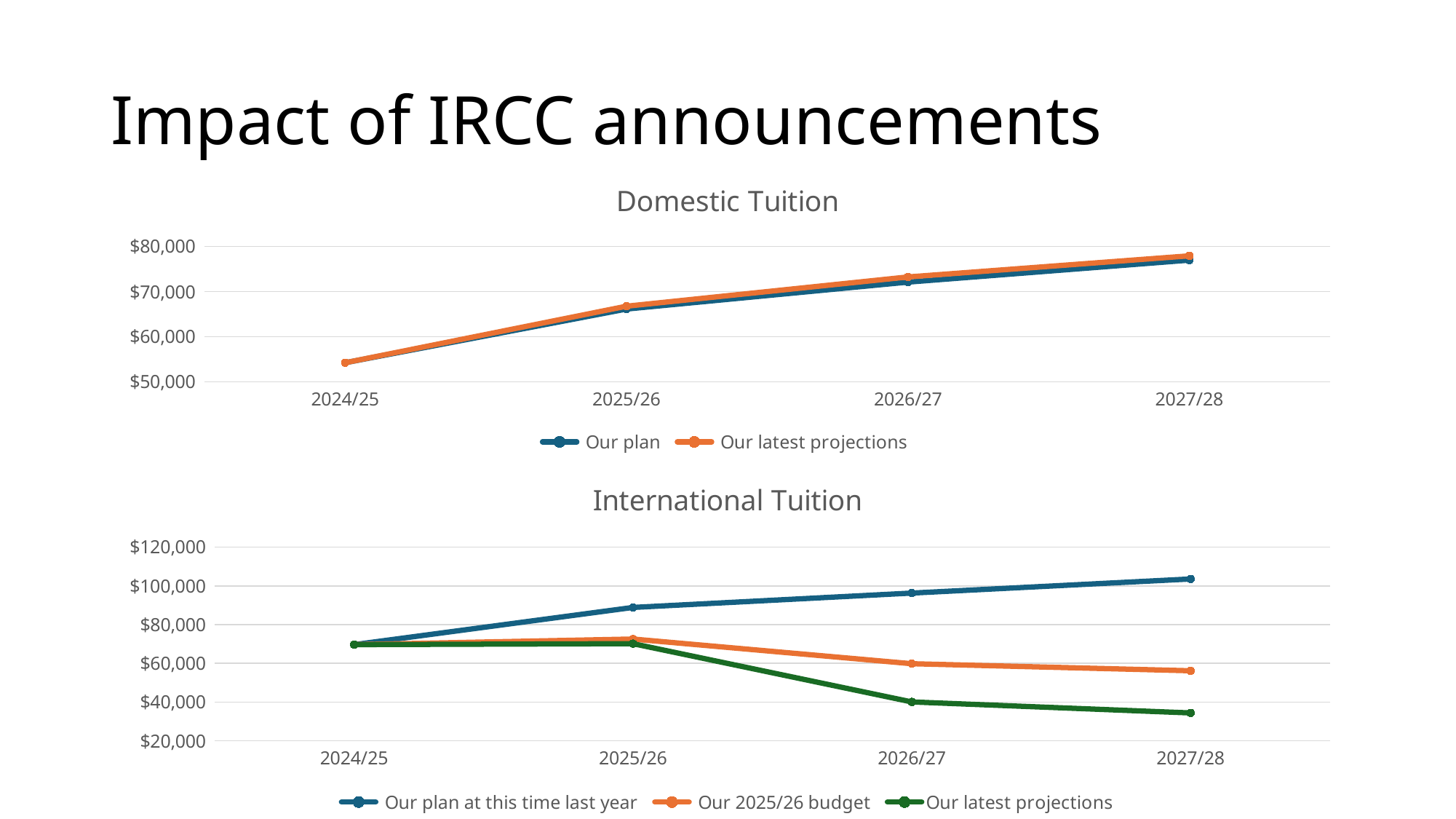
How many series does the legend of the Domestic Tuition chart list? 2 How many series does the legend of the International Tuition chart list? 3 In the Domestic Tuition chart, is the value for Our latest projections in 2024/25 greater or less than $60,000? less In the Domestic Tuition chart, do the values for Our plan rise or fall from 2024/25 to 2027/28? rise In the International Tuition chart, is the value for Our latest projections in 2027/28 greater or less than $40,000? less How many years are plotted along the x axis of the International Tuition chart? 4 In the International Tuition chart, do the values for Our latest projections rise or fall from 2025/26 to 2027/28? fall What is the title of the lower chart on the slide? International Tuition In the International Tuition chart, which series has the lowest value in 2027/28? Our latest projections In the International Tuition chart, is the value for Our plan at this time last year in 2027/28 greater or less than $100,000? greater What kind of chart is the Domestic Tuition chart? line chart In the International Tuition chart, which is larger in 2026/27: Our 2025/26 budget or Our latest projections? Our 2025/26 budget